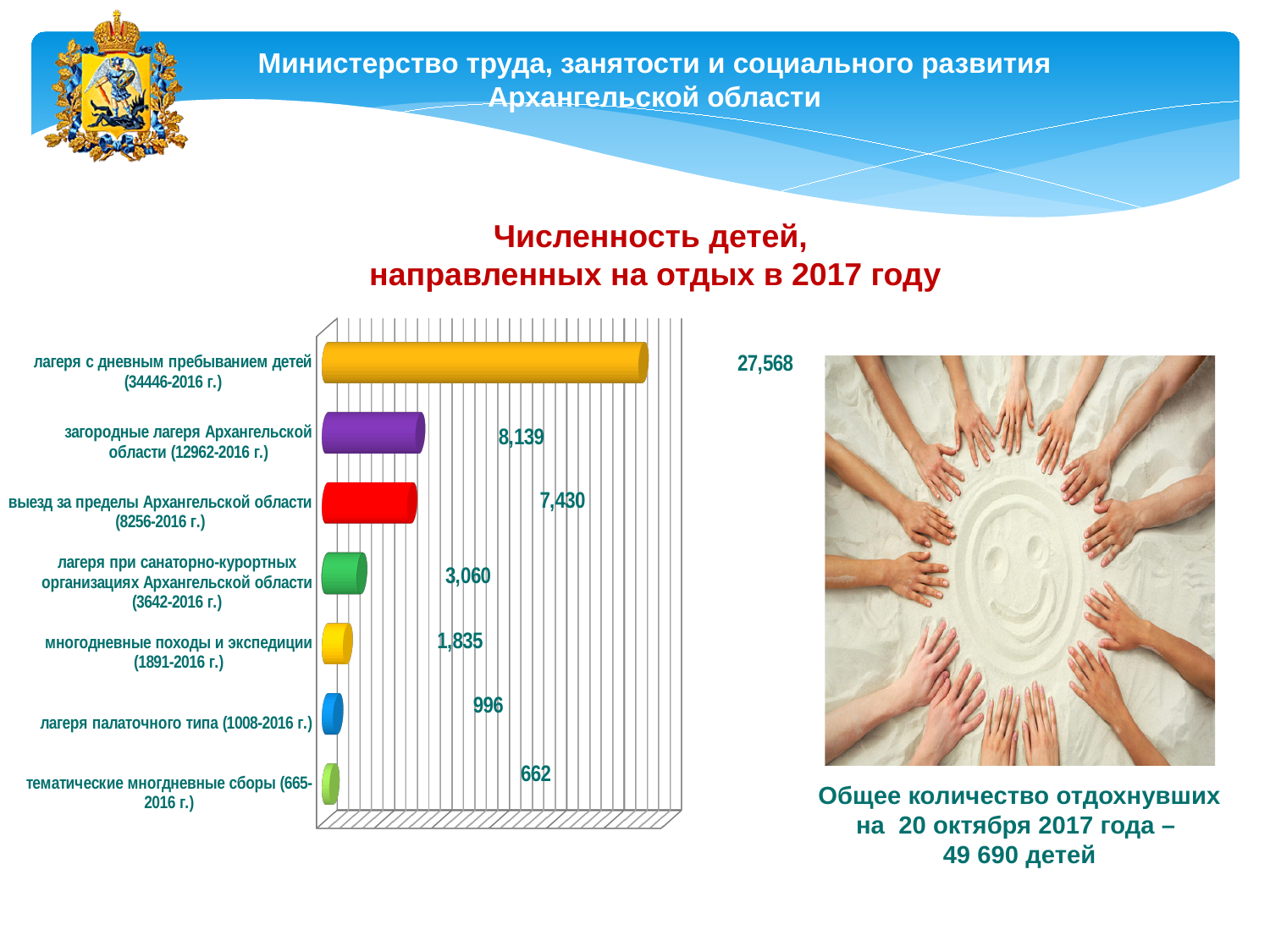
How many categories are shown in the chart? 7 What is the value for «лагеря с дневным пребыванием детей» in the chart? 27,568 What is the value for «загородные лагеря Архангельской области»? 8,139 What is the difference between the values for «лагеря палаточного типа» and «тематические многодневные сборы»? 334 What is the value for «выезд за пределы Архангельской области»? 7,430 Which category has the highest value in the chart? лагеря с дневным пребыванием детей What kind of chart is shown on the slide? bar chart Which is larger: the value for «загородные лагеря Архангельской области» or for «выезд за пределы Архангельской области»? загородные лагеря Архангельской области Which category has the lowest value in the chart? тематические многодневные сборы What is the value for «тематические многодневные сборы»? 662 What is the value for «лагеря палаточного типа»? 996 What is the difference between the values for «лагеря с дневным пребыванием детей» and «загородные лагеря Архангельской области»? 19,429